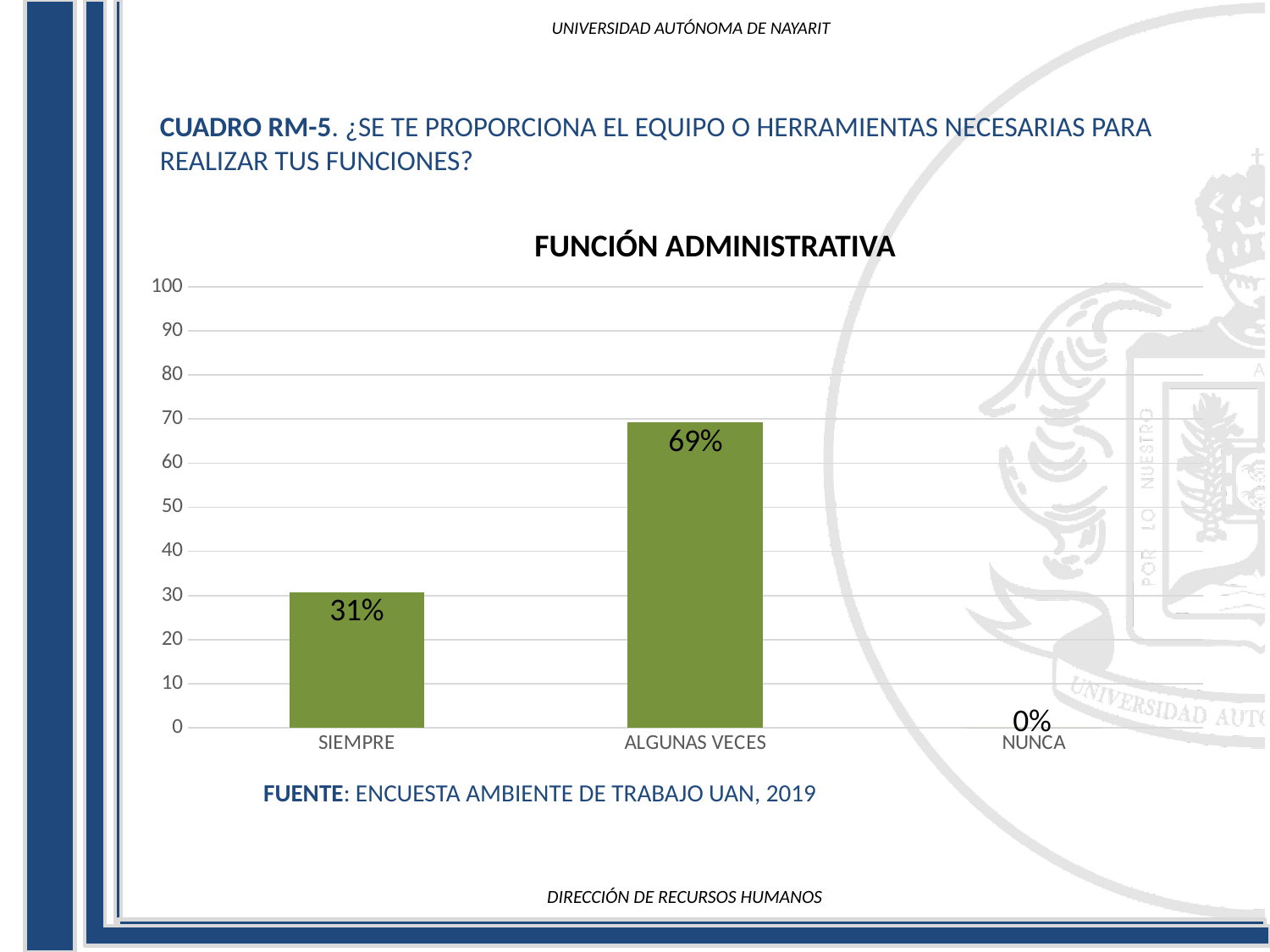
Which is larger, the value for SIEMPRE or the value for ALGUNAS VECES? ALGUNAS VECES What kind of chart is shown on the slide? bar chart Is the value for SIEMPRE greater or less than 40? less Which category has the highest value? ALGUNAS VECES What is the difference between the values for ALGUNAS VECES and SIEMPRE? 38% Is the value for ALGUNAS VECES greater or less than 50? greater What is the value for SIEMPRE? 31% What is the value for ALGUNAS VECES? 69% What is the title of the chart? FUNCIÓN ADMINISTRATIVA Which category has the lowest value? NUNCA How many categories are shown on the x axis? 3 What is the value for NUNCA? 0%